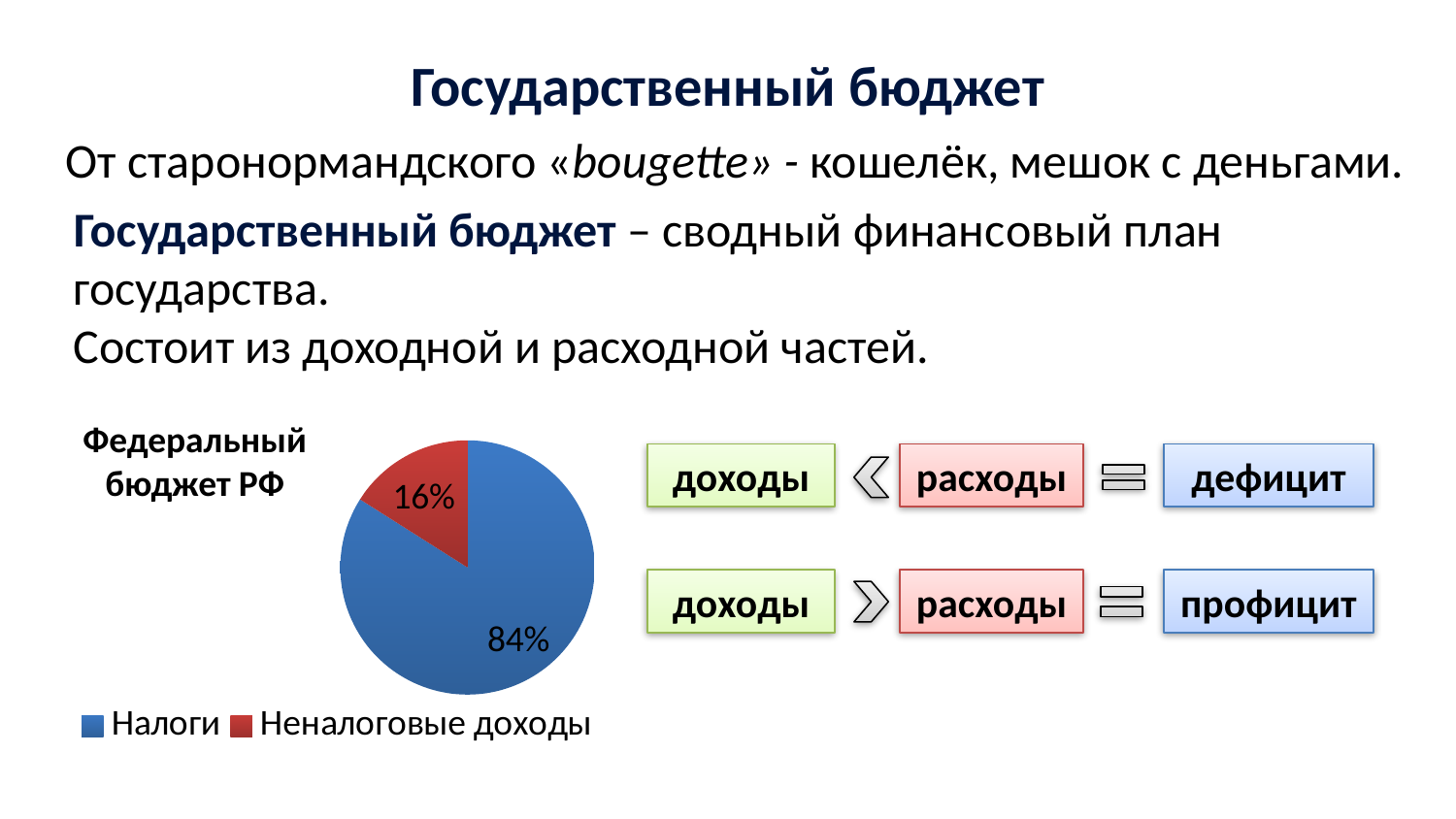
What colour is the Налоги slice in the pie chart? blue What is the difference in percentage points between the Налоги slice and the Неналоговые доходы slice? 68 What is the title of the pie chart? Федеральный бюджет РФ What share of the pie chart does Налоги take? 84% Which slice of the pie chart is the smallest? Неналоговые доходы Which slice of the pie chart is the largest? Налоги Which is larger in the pie chart, Налоги or Неналоговые доходы? Налоги How many slices does the pie chart have? 2 What share of the pie chart does Неналоговые доходы take? 16% How many entries does the legend of the pie chart list? 2 What kind of chart is shown on the slide? pie chart